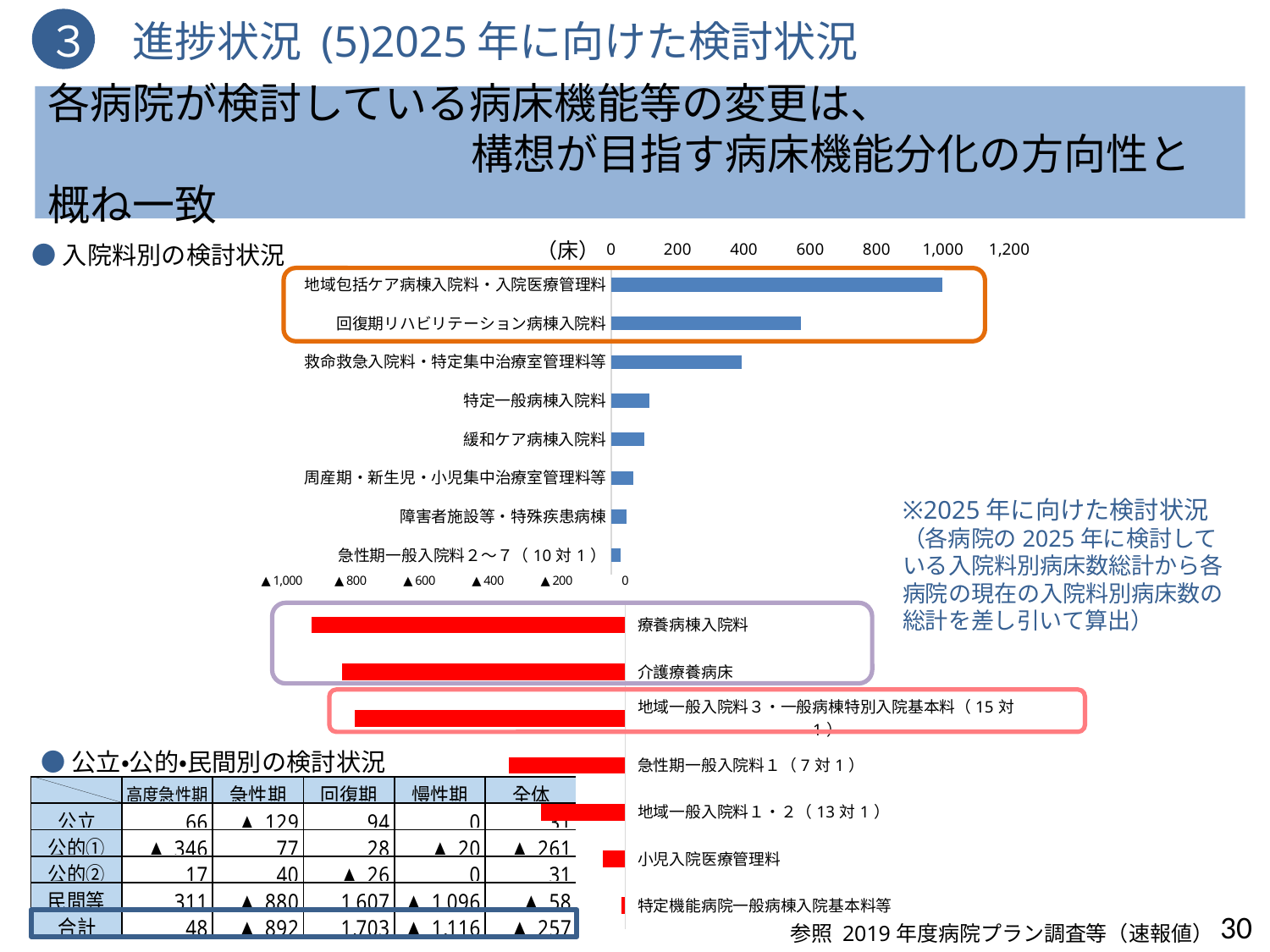
In the upper blue bar chart, which is larger: the value for 救命救急入院料・特定集中治療室管理料等 or the value for 緩和ケア病棟入院料? 救命救急入院料・特定集中治療室管理料等 In the upper blue bar chart, is the value for 特定一般病棟入院料 greater or less than 200? less In the lower red bar chart, which category shows the smallest decrease (shortest bar)? 特定機能病院一般病棟入院基本料等 In the lower red bar chart, which shows a larger decrease: 急性期一般入院料１（７対１） or 地域一般入院料１・２（13対１）? 急性期一般入院料１（７対１） In the upper blue bar chart, how many categories (入院料) are plotted? 8 In the upper blue bar chart, is the value for 地域包括ケア病棟入院料・入院医療管理料 greater or less than 800? greater In the upper blue bar chart, which category has the lowest value? 急性期一般入院料２～７（10対１） In the upper blue bar chart, which category has the highest value? 地域包括ケア病棟入院料・入院医療管理料 In the upper blue bar chart, is the value for 回復期リハビリテーション病棟入院料 greater or less than 400? greater In the lower red bar chart, which category shows the largest decrease (longest bar)? 療養病棟入院料 What kind of chart is the upper chart with the blue bars (入院料別の検討状況)? bar chart In the lower red bar chart (the ▲ decrease chart), how many categories are plotted? 7